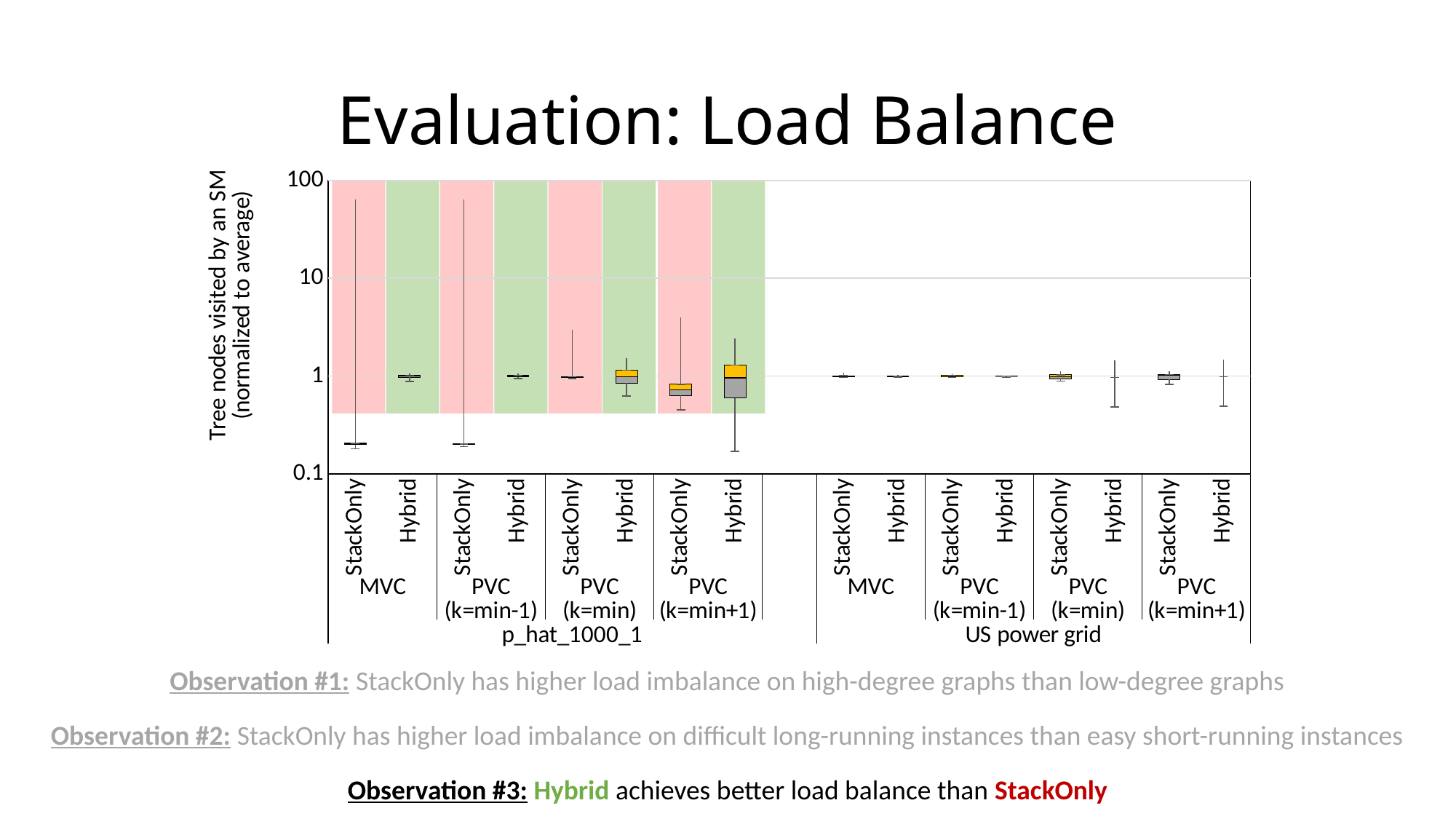
Is the top of the upper whisker for Hybrid on MVC for p_hat_1000_1 greater or less than 10? less What is the title of the slide containing the chart? Evaluation: Load Balance Which graph instance has its boxes highlighted with pink and green shaded backgrounds? p_hat_1000_1 How many problem categories are shown for the p_hat_1000_1 graph? 4 Is the top of the upper whisker for StackOnly on MVC for p_hat_1000_1 greater or less than 10? greater What is the label of the y axis? Tree nodes visited by an SM (normalized to average) What is the highest tick value shown on the y axis? 100 How many boxes are plotted in total across the chart? 16 What kind of chart is shown on the slide? box plot (box-and-whisker chart) What is the lowest tick value shown on the y axis? 0.1 Is the bottom of the lower whisker for StackOnly on PVC (k=min-1) for p_hat_1000_1 greater or less than 1? less How many graph instances (bottom-level x-axis groups) are shown in the chart? 2